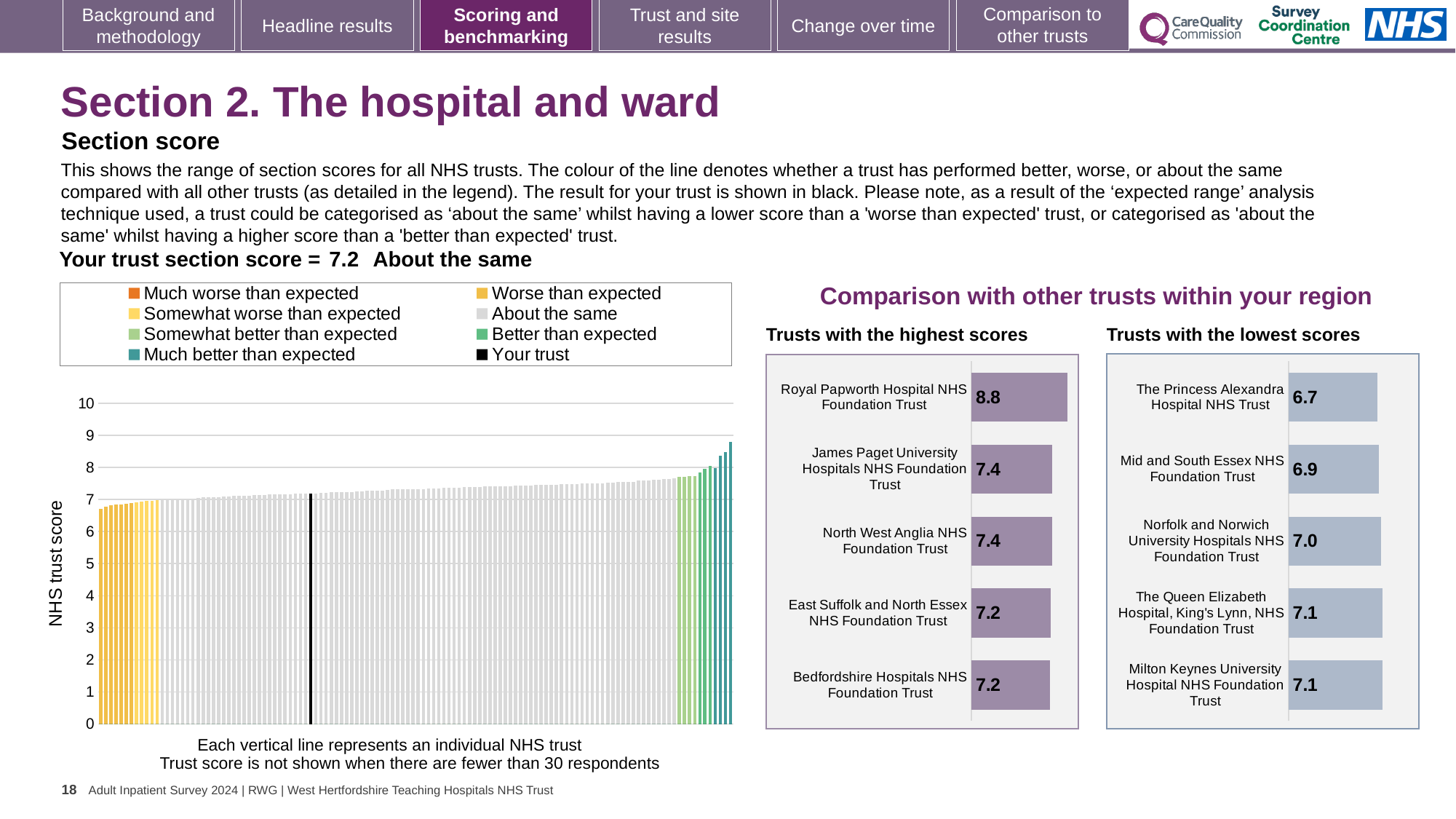
What kind of chart is the large 'NHS trust score' chart on the left of the slide? Bar chart In the 'Trusts with the highest scores' chart, what is the score for Royal Papworth Hospital NHS Foundation Trust? 8.8 In the 'Trusts with the highest scores' chart, which trust has the highest score? Royal Papworth Hospital NHS Foundation Trust In the 'Trusts with the lowest scores' chart, which trust has the lowest score? The Princess Alexandra Hospital NHS Trust In the 'Trusts with the lowest scores' chart, what is the score for The Princess Alexandra Hospital NHS Trust? 6.7 In the 'NHS trust score' chart, is the value of the tallest bar greater or less than 8? greater In the 'Trusts with the highest scores' chart, what is the difference between the scores of Royal Papworth Hospital NHS Foundation Trust and Bedfordshire Hospitals NHS Foundation Trust? 1.6 How many entries does the legend of the 'NHS trust score' chart list? 8 In the 'Trusts with the lowest scores' chart, what is the difference between the scores of Norfolk and Norwich University Hospitals NHS Foundation Trust and Mid and South Essex NHS Foundation Trust? 0.1 In the 'NHS trust score' chart, do the bars rise or fall from left to right? Rise In the 'Trusts with the lowest scores' chart, which has the higher score: Mid and South Essex NHS Foundation Trust or Milton Keynes University Hospital NHS Foundation Trust? Milton Keynes University Hospital NHS Foundation Trust How many trusts are shown in the 'Trusts with the lowest scores' chart? 5